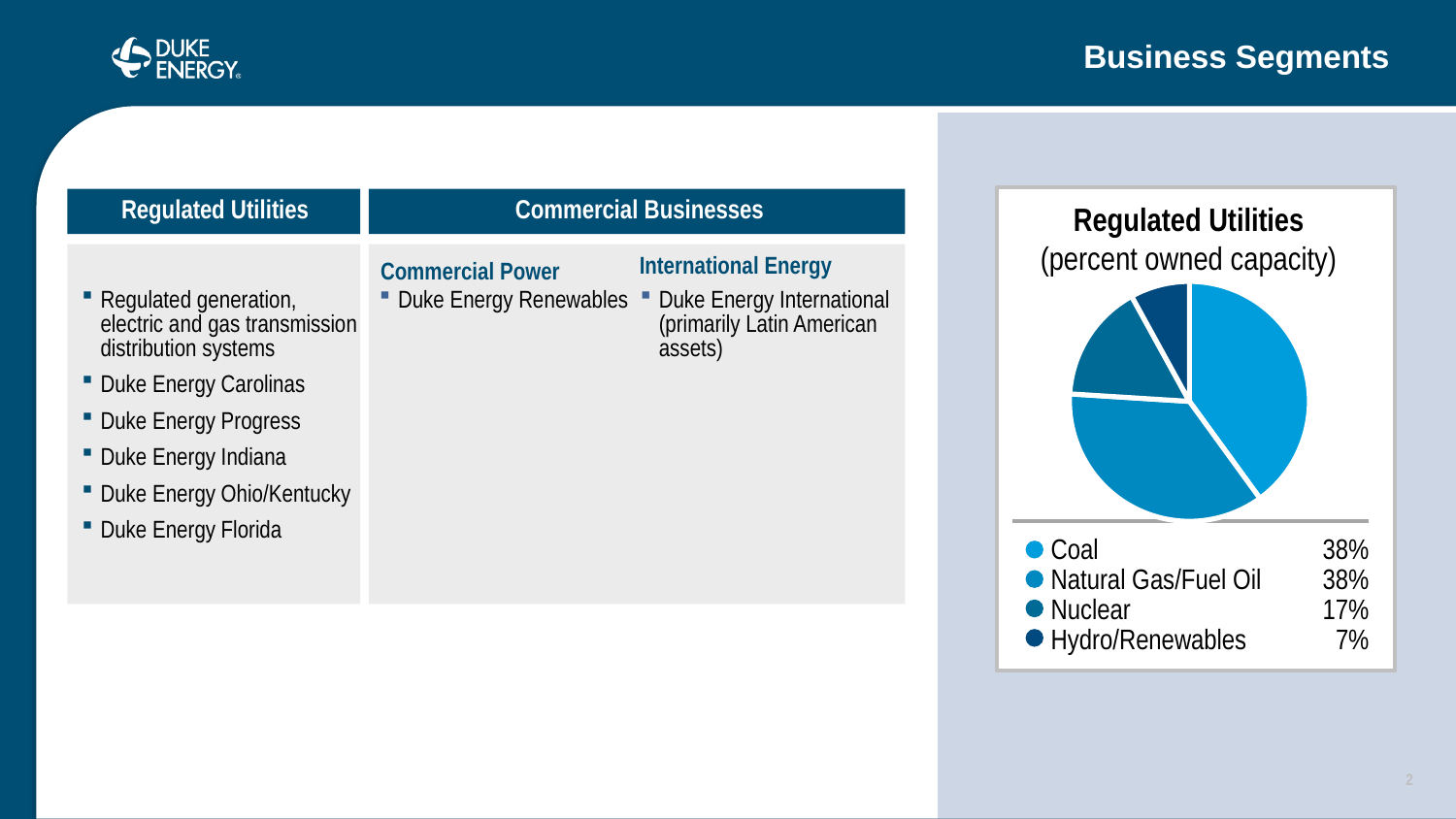
What percentage of owned capacity is Nuclear? 17% What percentage of owned capacity is Natural Gas/Fuel Oil? 38% What is the difference between the Coal share and the Nuclear share? 21% How many categories does the pie chart show? 4 What is the difference between the Nuclear share and the Hydro/Renewables share? 10% What kind of chart is shown on the slide? pie chart Which category has the smallest share of owned capacity? Hydro/Renewables Which is larger, the share for Nuclear or the share for Hydro/Renewables? Nuclear What is the title of the chart? Regulated Utilities (percent owned capacity) What percentage of owned capacity is Hydro/Renewables? 7% What percentage of owned capacity is Coal? 38% What is the combined share of Coal and Natural Gas/Fuel Oil? 76%